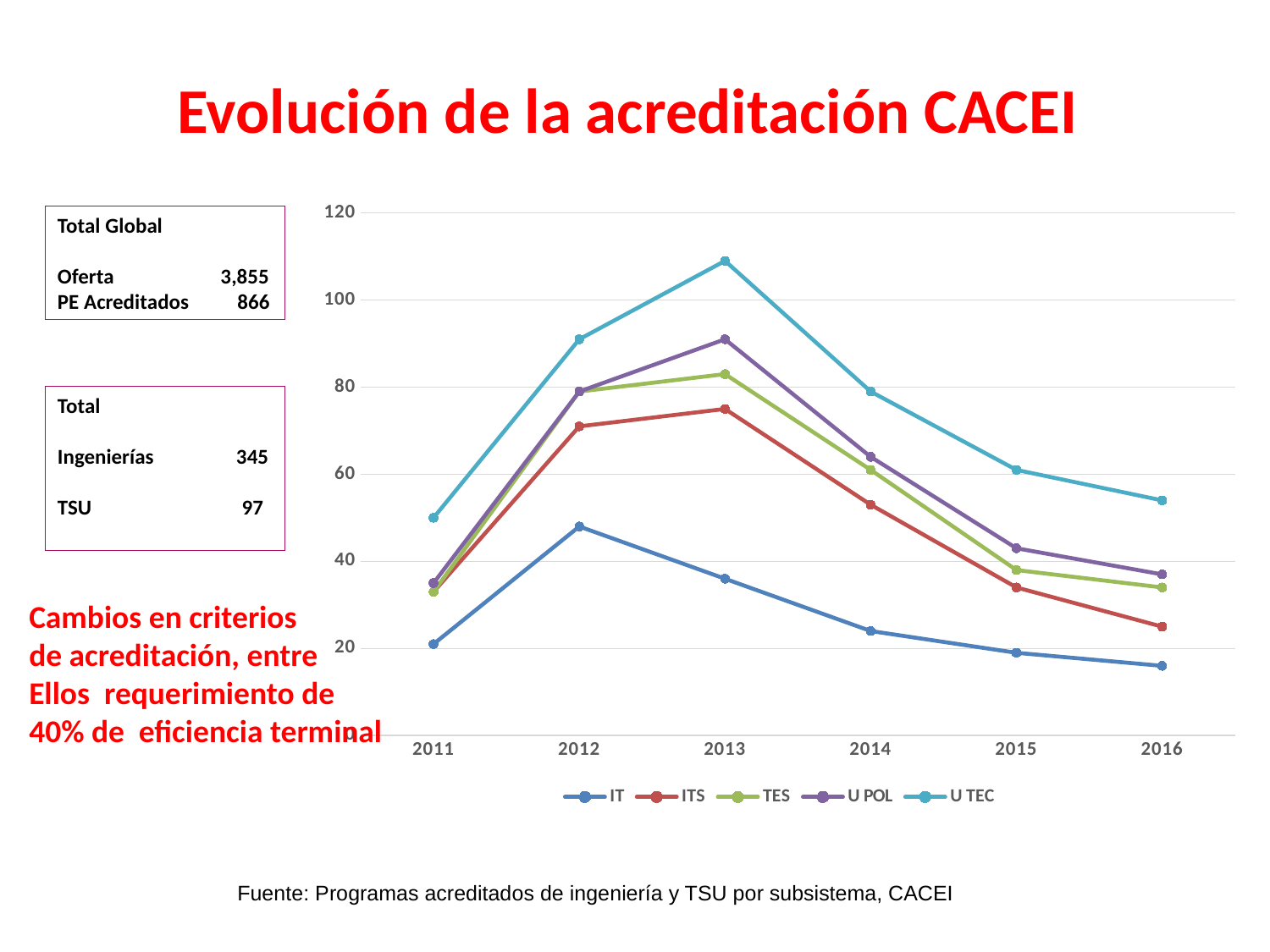
Which series has the lowest value in 2016? IT Is the value for U POL in 2013 greater or less than 80? greater Which is larger in 2012, the value for U TEC or the value for U POL? U TEC Is the value for U TEC in 2013 greater or less than 100? greater How many years are shown along the x axis of the chart? 6 Do the values for IT rise or fall from 2013 to 2016? fall How many series does the chart's legend list? 5 What kind of chart is shown on the slide? line chart Which series has the highest value in 2013? U TEC Is the value for IT in 2016 greater or less than 20? less In which year does the U TEC series reach its peak? 2013 What are the series names listed in the chart's legend? IT, ITS, TES, U POL, U TEC